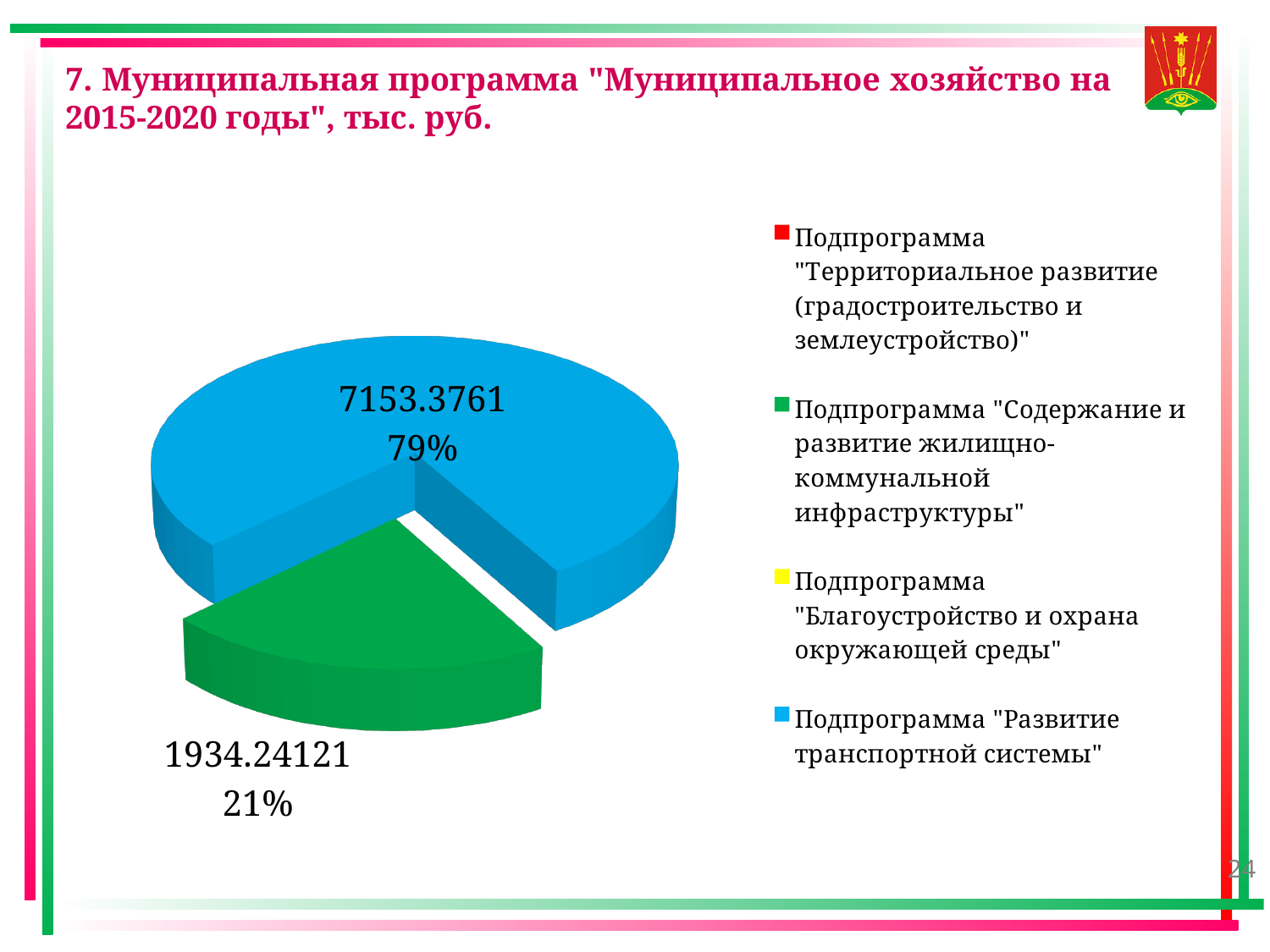
What is the value for the subprogram "Содержание и развитие жилищно-коммунальной инфраструктуры"? 1934.24121 What colour is the slice for the subprogram "Развитие транспортной системы"? blue What kind of chart is shown on the slide? pie chart How many entries does the legend list? 4 Which is larger: the value for "Развитие транспортной системы" or the value for "Содержание и развитие жилищно-коммунальной инфраструктуры"? Развитие транспортной системы What share of the pie does the subprogram "Развитие транспортной системы" take? 79% What is the value for the subprogram "Развитие транспортной системы"? 7153.3761 Which subprogram has the largest slice of the pie? Подпрограмма "Развитие транспортной системы" Which of the two visible slices is smaller, the blue one or the green one? the green one What is the difference between the value for "Развитие транспортной системы" and the value for "Содержание и развитие жилищно-коммунальной инфраструктуры"? 5219.13489 What share of the pie does the subprogram "Содержание и развитие жилищно-коммунальной инфраструктуры" take? 21% What is the total of the two labelled slices in the pie? 9087.61731